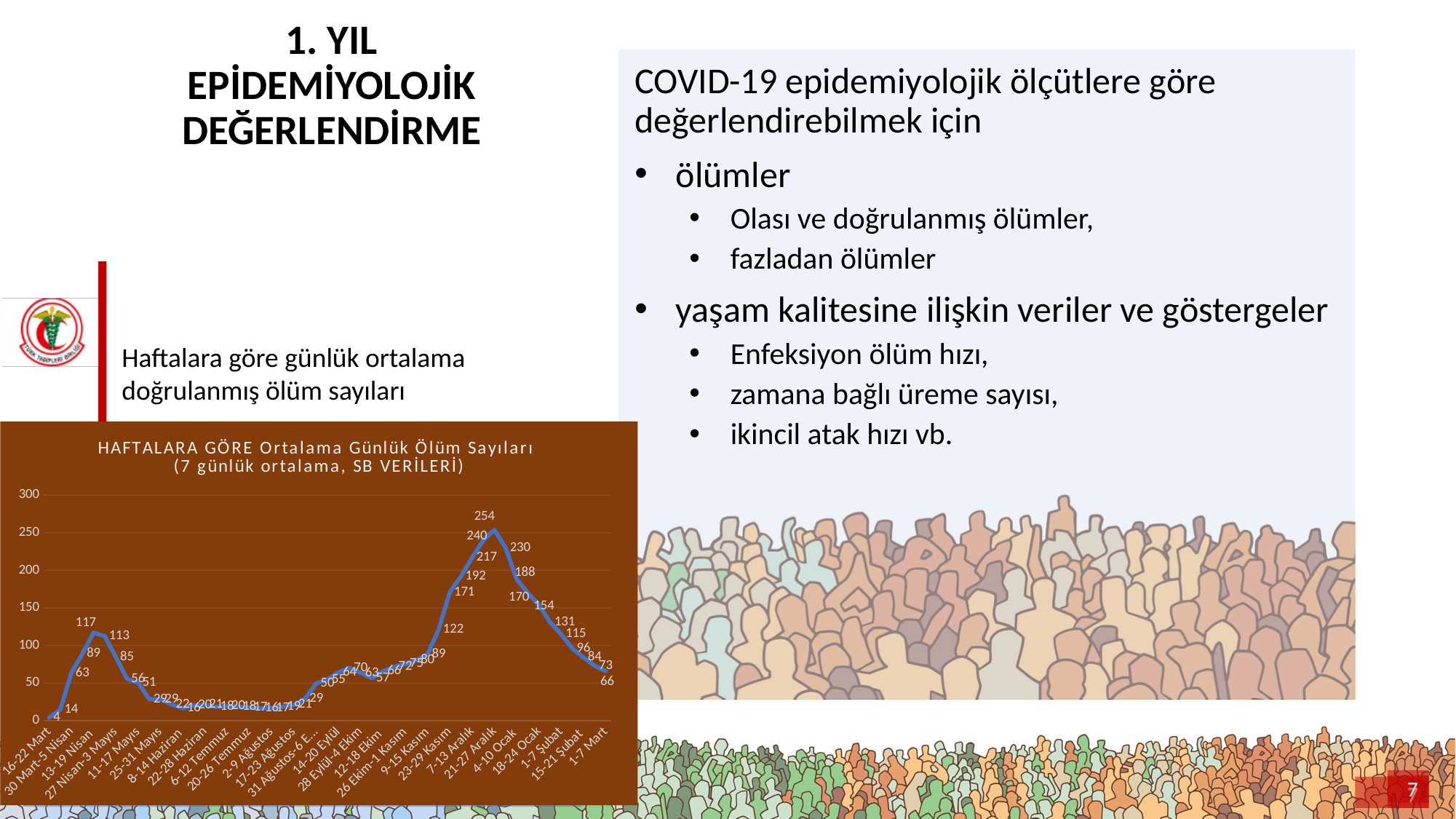
What is the difference between the highest labelled value (254) and the value for 1-7 Mart (66)? 188 How many data series are plotted in the chart? 1 What is the value for the first week, 16-22 Mart, in the chart? 4 Is the value for 1-7 Mart greater or less than 100? less What is the title of the chart? HAFTALARA GÖRE Ortalama Günlük Ölüm Sayıları (7 günlük ortalama, SB VERİLERİ) What is the highest value labelled on the line in the chart? 254 Does the line rise or fall from the 254 peak to the end of the chart at 1-7 Mart? fall Which peak is higher: the spring peak (117) or the winter peak (254)? the winter peak (254) What kind of chart is shown on the slide? line chart What is the highest tick value shown on the y axis of the chart? 300 What is the value for the last week, 1-7 Mart, in the chart? 66 What is the value at the first (spring) peak of the line in the chart? 117